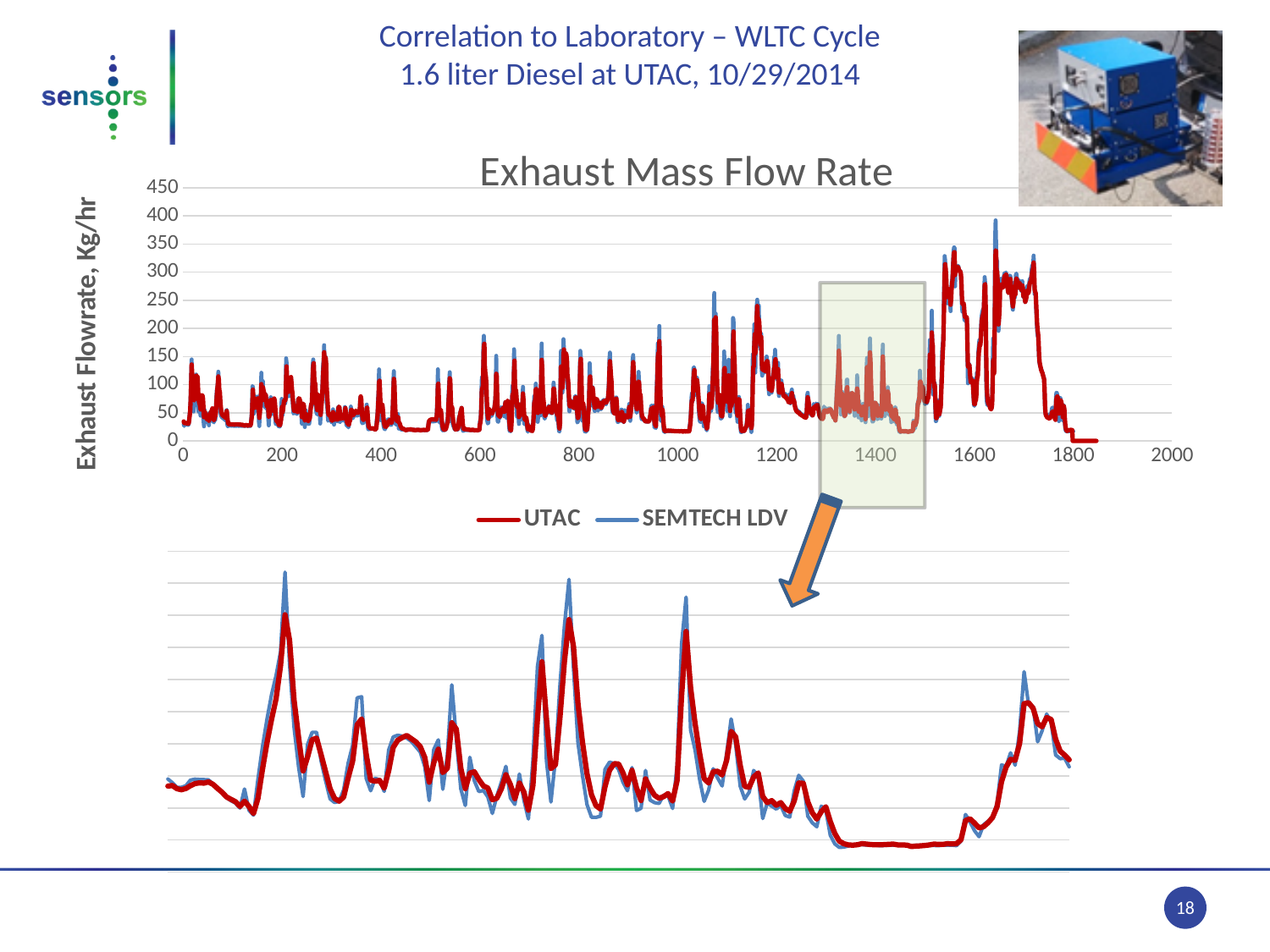
What is the highest value shown on the y-axis of the Exhaust Mass Flow Rate chart? 450 In the Exhaust Mass Flow Rate chart, is the UTAC value at x = 1550 greater or less than 250? greater What are the two series named in the legend of the Exhaust Mass Flow Rate chart? UTAC and SEMTECH LDV How many series does the legend of the Exhaust Mass Flow Rate chart list? 2 What is the y-axis label of the Exhaust Mass Flow Rate chart? Exhaust Flowrate, Kg/hr In the Exhaust Mass Flow Rate chart, is the UTAC value at x = 1800 greater or less than 50? less In the Exhaust Mass Flow Rate chart, is the highest peak of the SEMTECH LDV series (near x = 1640) greater or less than 350? greater In the Exhaust Mass Flow Rate chart, do the values rise or fall between x = 1500 and x = 1550? rise What kind of chart is the Exhaust Mass Flow Rate chart? line chart In the Exhaust Mass Flow Rate chart, do the values rise or fall between x = 1700 and x = 1800? fall